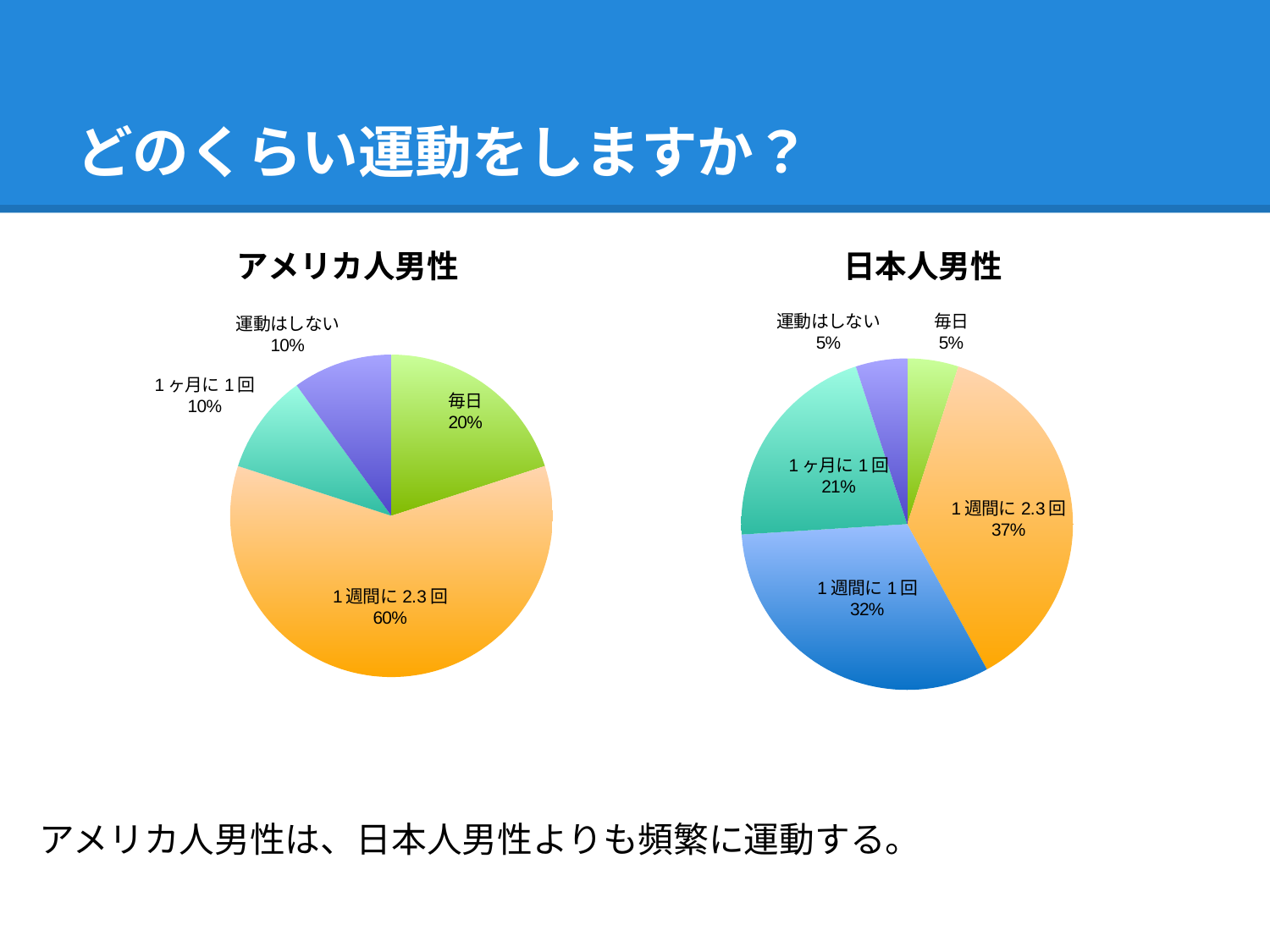
In the 日本人男性 pie chart, what percentage is shown for 1週間に1回? 32% In the 日本人男性 pie chart, which category has the largest share? 1週間に2.3回 In the アメリカ人男性 pie chart, what percentage is shown for 1週間に2.3回? 60% Which is larger: the 1ヶ月に1回 share for アメリカ人男性 or for 日本人男性? 日本人男性 How many categories are shown in the アメリカ人男性 pie chart? 4 In the アメリカ人男性 pie chart, which category has the largest share? 1週間に2.3回 In the 日本人男性 pie chart, what percentage is shown for 1ヶ月に1回? 21% What type of chart is used on this slide? Pie chart In the 日本人男性 pie chart, what is the difference between the 1週間に2.3回 share and the 1週間に1回 share? 5% How many categories are shown in the 日本人男性 pie chart? 5 In the アメリカ人男性 pie chart, which category has the smallest share, 毎日 or 運動はしない? 運動はしない What is the difference between the 毎日 share in the アメリカ人男性 chart and the 毎日 share in the 日本人男性 chart? 15%